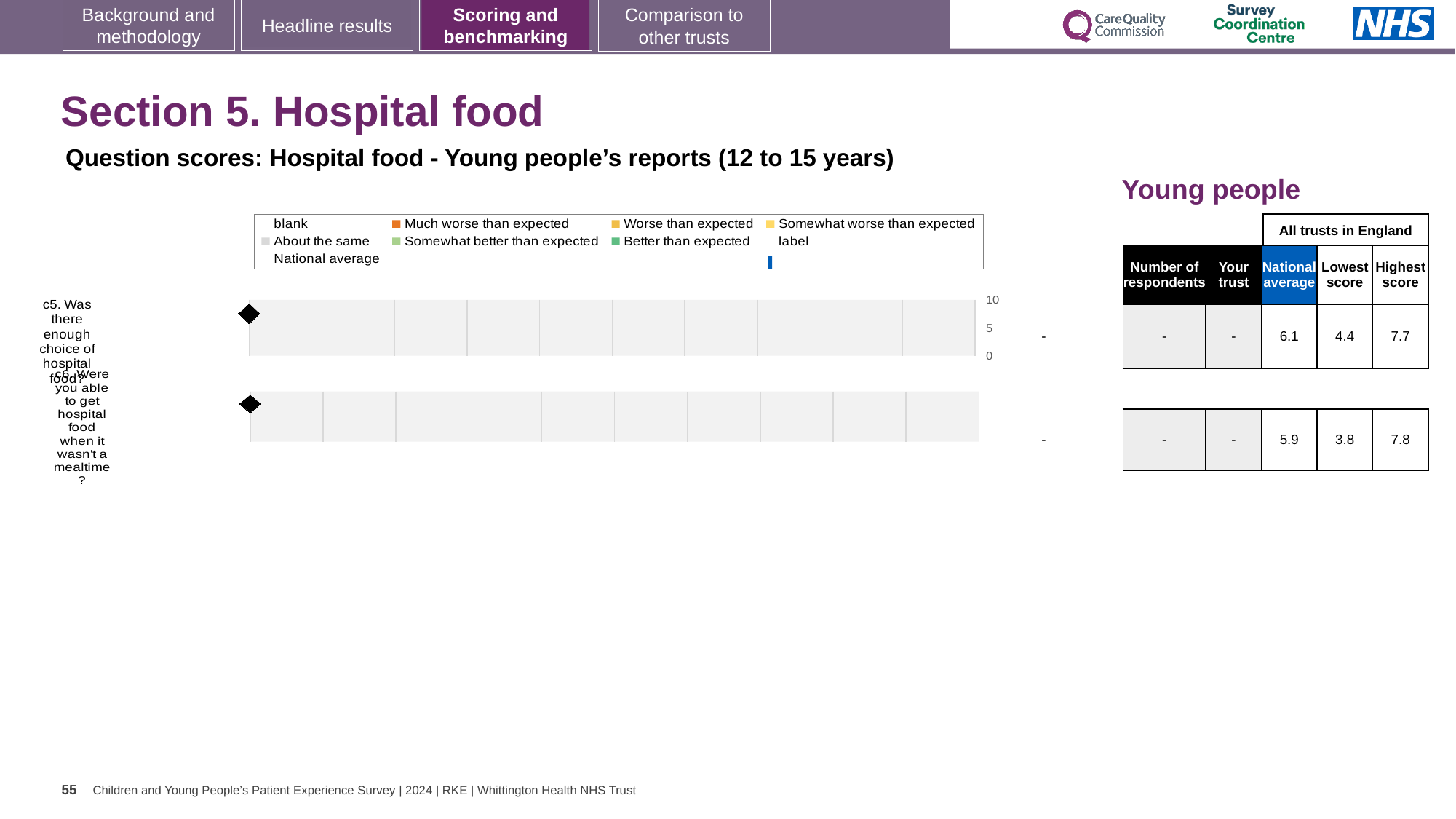
In the table next to the chart, what is the national average score for c6 (Were you able to get hospital food when it wasn't a mealtime?)? 5.9 What kind of chart is shown on the slide? bar chart Which question has the higher national average in the table, c5 or c6? c5 Is the national average for c6 (5.9) greater or less than 5 on the chart's axis? greater In the table next to the chart, what is the lowest score across all trusts in England for c5? 4.4 In the table next to the chart, what is the highest score across all trusts in England for c6? 7.8 Which question is plotted first (at the top) of the chart? c5. Was there enough choice of hospital food? How many questions (categories) are plotted on the chart? 2 What is the value shown for 'Your trust' for c5 in the table? - What is the difference between the highest score (7.7) and the lowest score (4.4) for c5 in the table? 3.3 In the table next to the chart, what is the national average score for c5 (Was there enough choice of hospital food?)? 6.1 What is the highest value shown on the chart's axis? 10